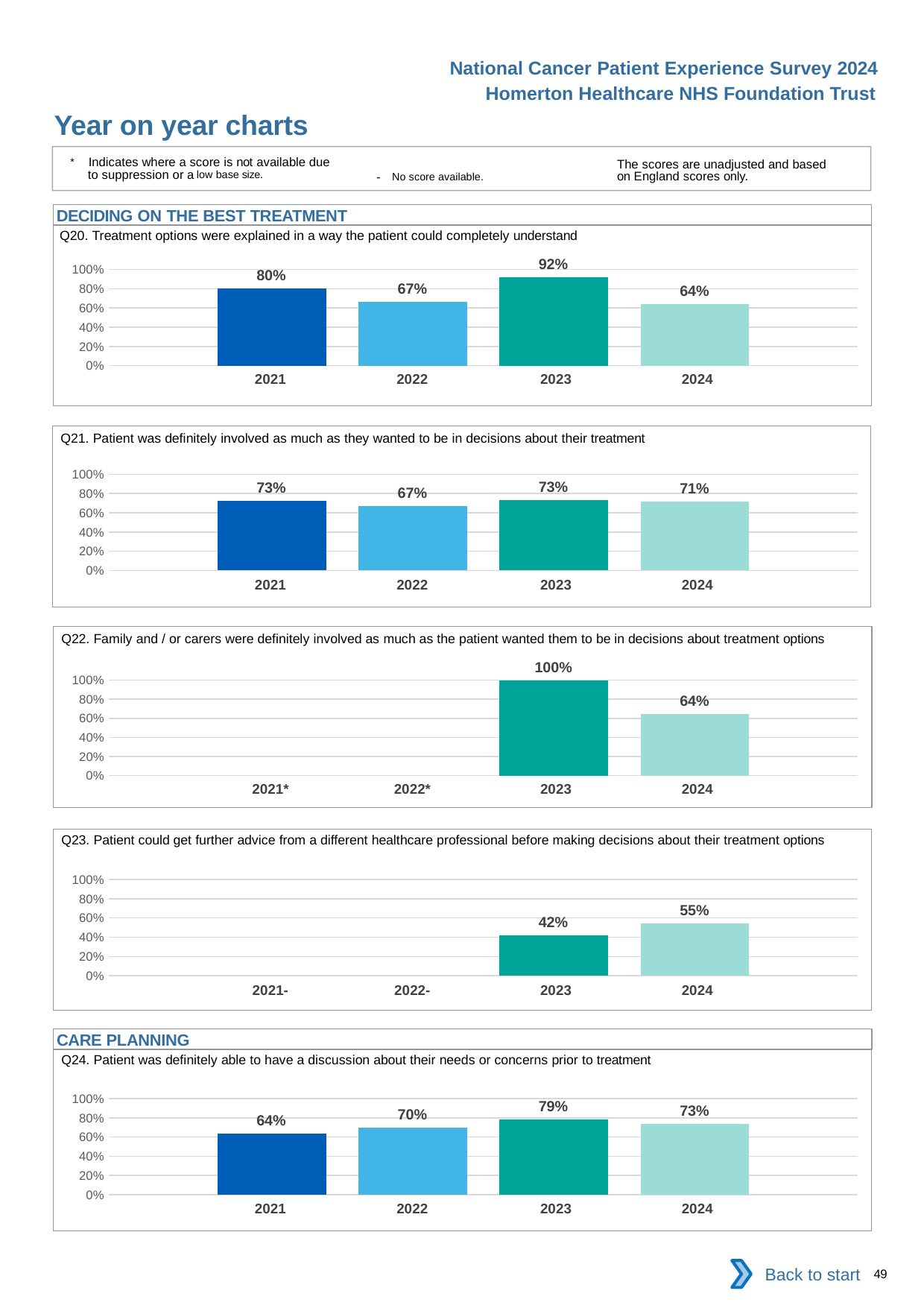
What kind of chart is the Q24 chart? Bar chart In the Q22 chart, what is the value for 2023? 100% In the Q20 chart, which year has the lowest value? 2024 In the Q20 chart, what is the difference between the 2021 and 2022 values? 13% In the Q22 chart, how many years have a bar plotted? 2 In the Q23 chart, what is the value for 2024? 55% In the Q24 chart, what is the difference between the 2023 and 2024 values? 6% In the Q20 chart, what is the value for 2023? 92% In the Q21 chart, which year has the lowest value? 2022 In the Q21 chart, what is the value for 2024? 71% In the Q24 chart, which year has the highest value? 2023 In the Q23 chart, which is larger, the 2023 value or the 2024 value? 2024